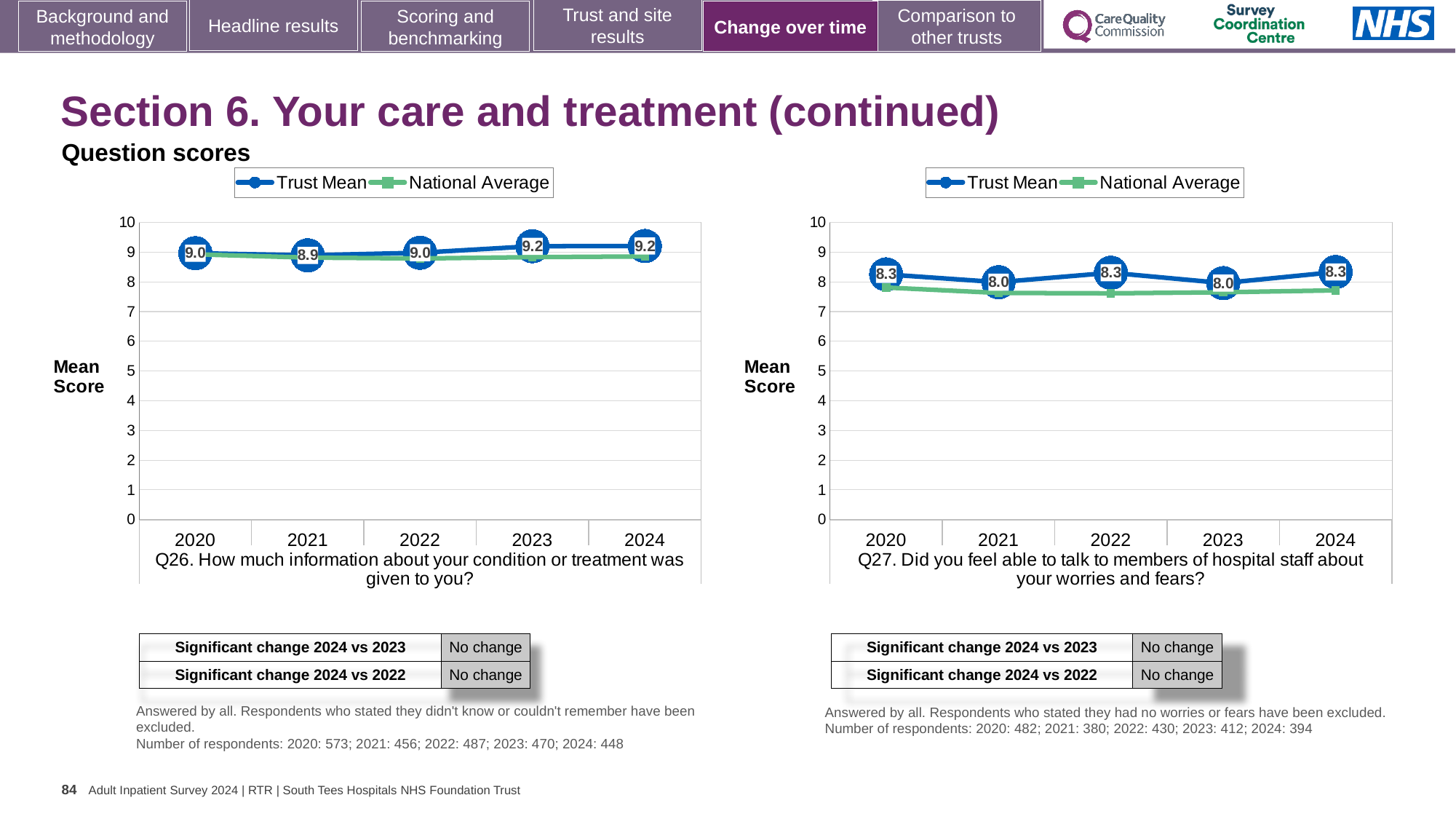
In the Q26 chart, what is the difference between the Trust Mean scores for 2024 and 2021? 0.3 How many series does the legend of the Q26 chart list? 2 What type of chart is used for Q26? Line chart In the Q26 chart, what is the Trust Mean score for 2021? 8.9 In the Q27 chart, is the Trust Mean score for 2021 greater or less than 9? less In the Q26 chart, what is the Trust Mean score for 2024? 9.2 In the Q27 chart, what is the Trust Mean score for 2020? 8.3 In the Q27 chart, what is the Trust Mean score for 2023? 8.0 How many years are shown on the x axis of the Q27 chart? 5 In the Q27 chart, what is the difference between the Trust Mean scores for 2022 and 2021? 0.3 In the Q26 chart, which year has the lowest Trust Mean score? 2021 In the Q26 chart, is the Trust Mean score for 2023 greater or less than 8? greater